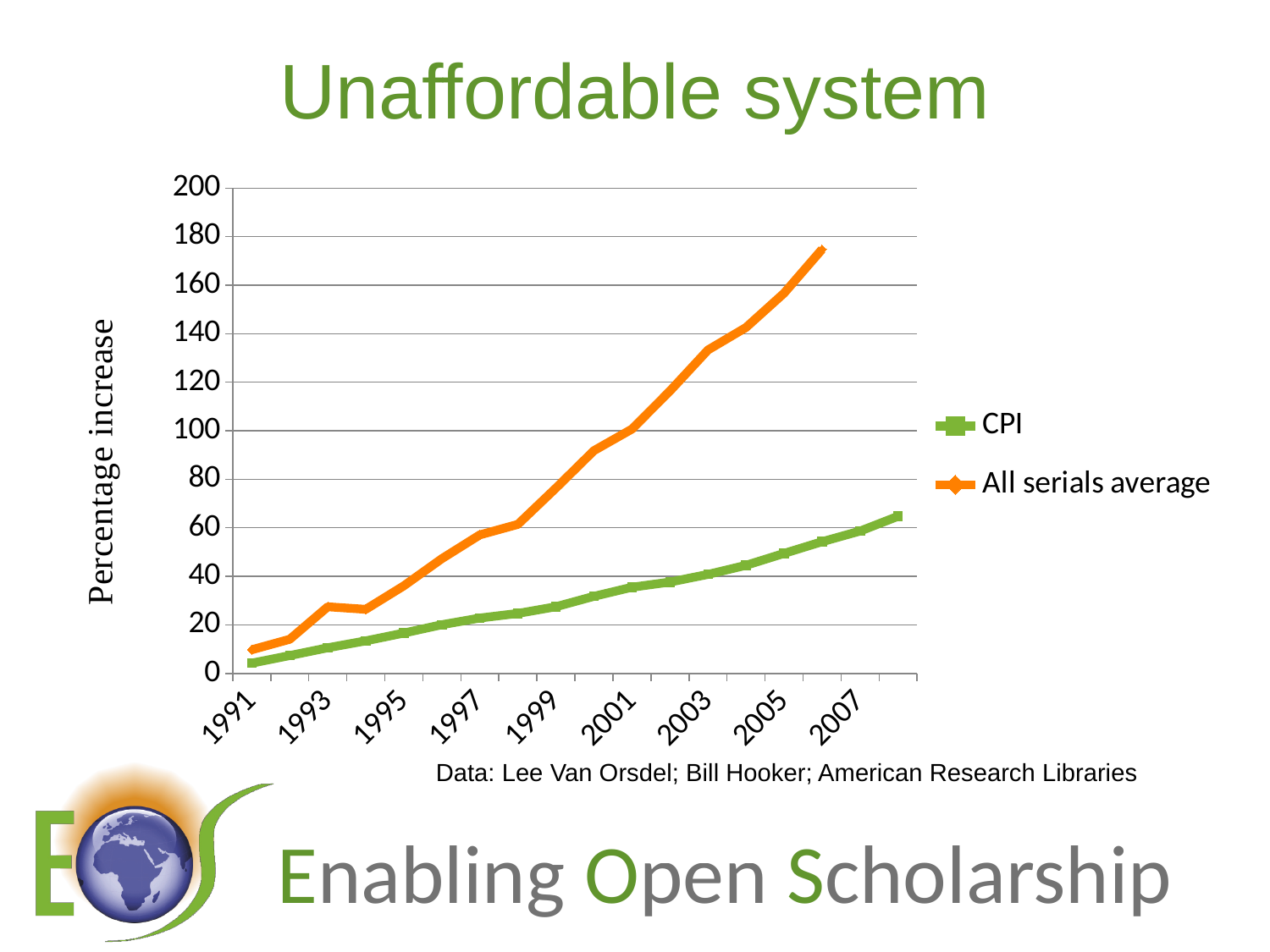
What are the two series named in the legend? CPI and All serials average Is the value for All serials average in 2001 greater or less than 80? greater Is the value for CPI in 2007 greater or less than 100? less How many year labels are shown on the x axis? 9 What is the label on the vertical axis? Percentage increase How many series does the legend list? 2 Does the CPI line rise or fall across the years shown? rise What kind of chart is shown on the slide? line chart In 1999, which series is higher, CPI or All serials average? All serials average Does the All serials average line rise or fall from 1991 to 2007? rise Is the value for All serials average in 1995 greater or less than 60? less